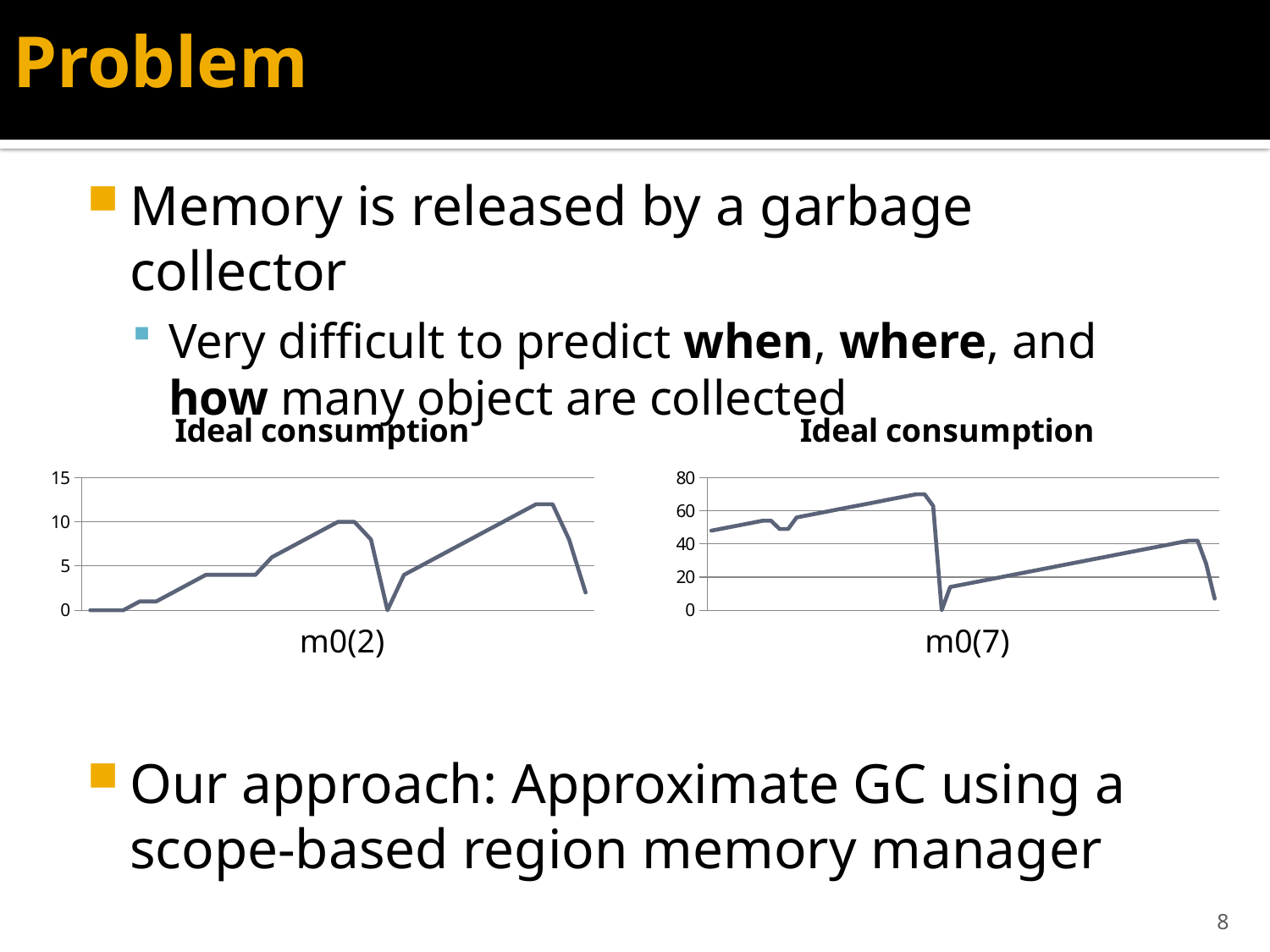
In the left chart labelled m0(2), what is the highest value shown on the y axis? 15 In the left chart labelled m0(2), is the starting value of the line greater or less than 5? less In the left chart labelled m0(2), is the highest peak of the line greater or less than 10? greater What kind of chart is the left chart labelled m0(2)? line chart What kind of chart is the right chart labelled m0(7)? line chart In the right chart labelled m0(7), what is the highest value shown on the y axis? 80 What is the title of the left chart labelled m0(2)? Ideal consumption In the right chart labelled m0(7), is the highest peak of the line greater or less than 60? greater How many charts are shown on the slide? 2